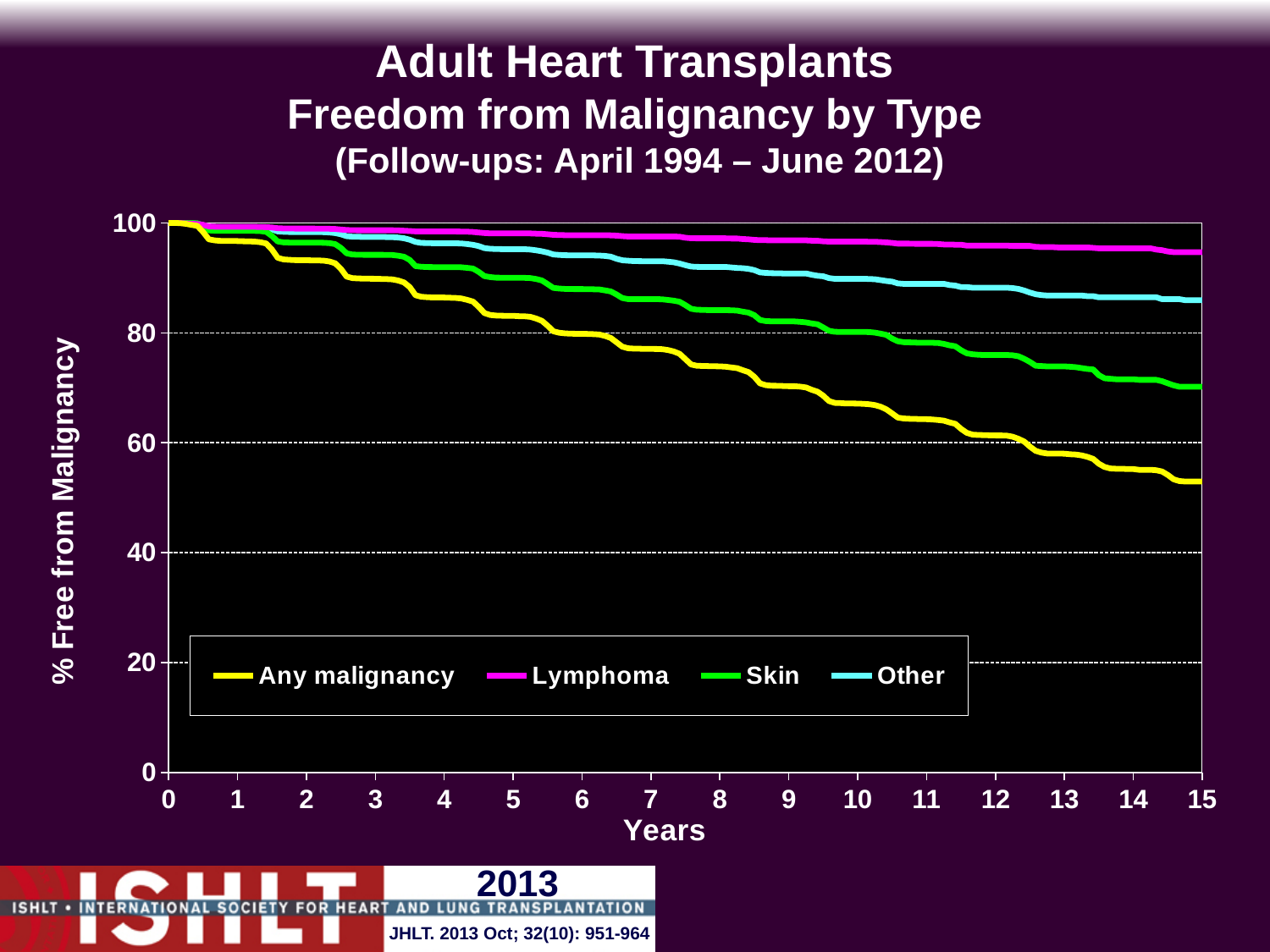
What is the label of the x axis? Years Which series has the lowest value at 15 years? Any malignancy At 10 years, which is larger, the value for Skin or the value for Other? Other Which series does the legend show in yellow? Any malignancy How many series does the legend list? 4 Is the value for Any malignancy at 15 years greater or less than 60? less What kind of chart is shown on the slide? line chart Is the value for Other at 15 years greater or less than 80? greater Is the value for Skin at 15 years greater or less than 80? less Do the values for the Any malignancy series rise or fall as years increase? fall Which series has the highest value at 15 years? Lymphoma